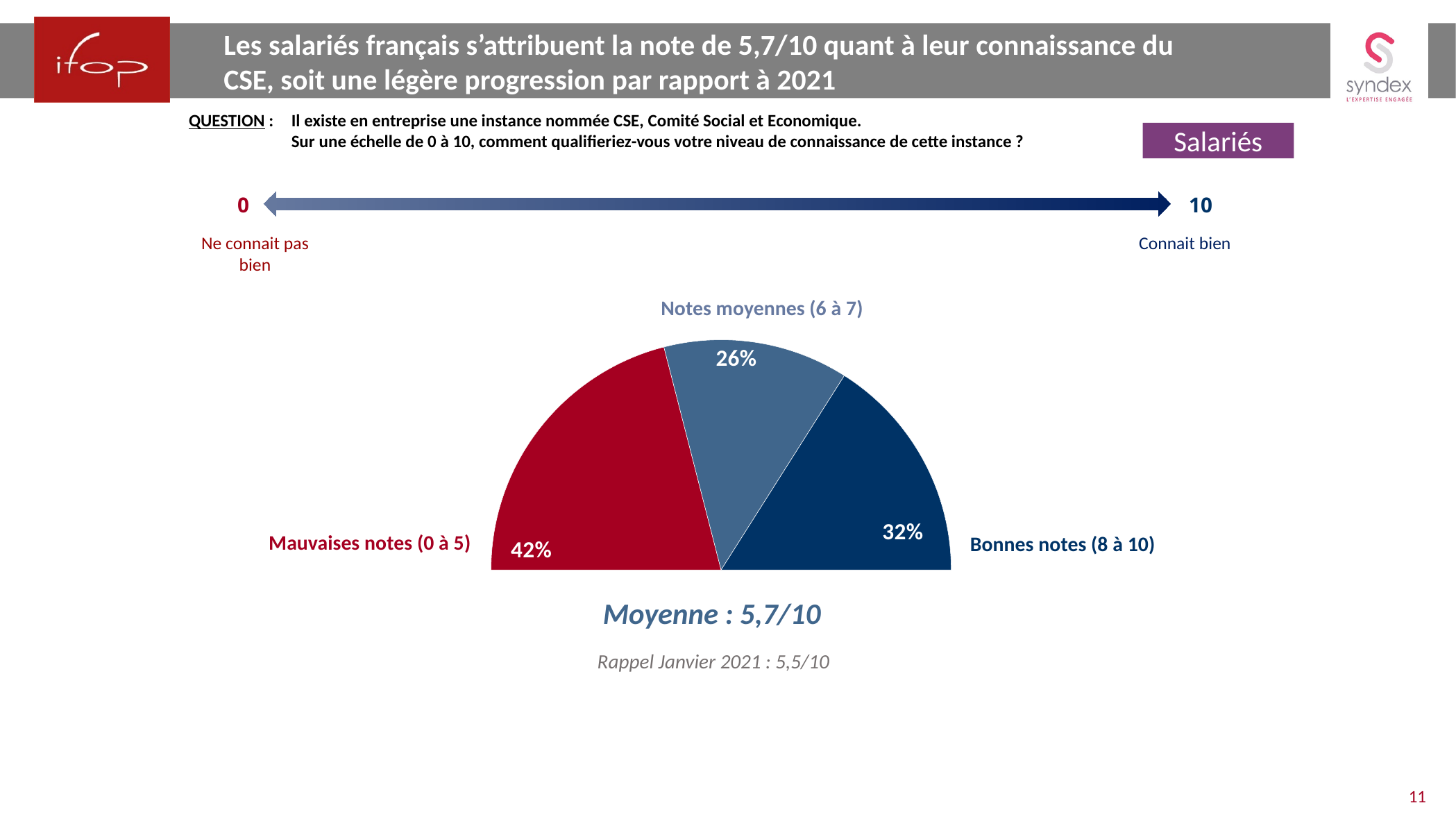
How many categories are shown in the chart? 3 What percentage of respondents gave 'Mauvaises notes (0 à 5)'? 42% What was the average score recalled for January 2021? 5,5/10 What percentage of respondents gave 'Bonnes notes (8 à 10)'? 32% Which category has the smallest share of the chart? Notes moyennes (6 à 7) Which category has the largest share of the chart? Mauvaises notes (0 à 5) What is the difference in percentage points between 'Bonnes notes (8 à 10)' and 'Notes moyennes (6 à 7)'? 6 Which is larger: the share for 'Bonnes notes (8 à 10)' or for 'Notes moyennes (6 à 7)'? Bonnes notes (8 à 10) What percentage of respondents gave 'Notes moyennes (6 à 7)'? 26% What kind of chart is shown on the slide? Pie chart (half pie) What average score (Moyenne) is shown below the chart? 5,7/10 What is the difference in percentage points between 'Mauvaises notes (0 à 5)' and 'Bonnes notes (8 à 10)'? 10